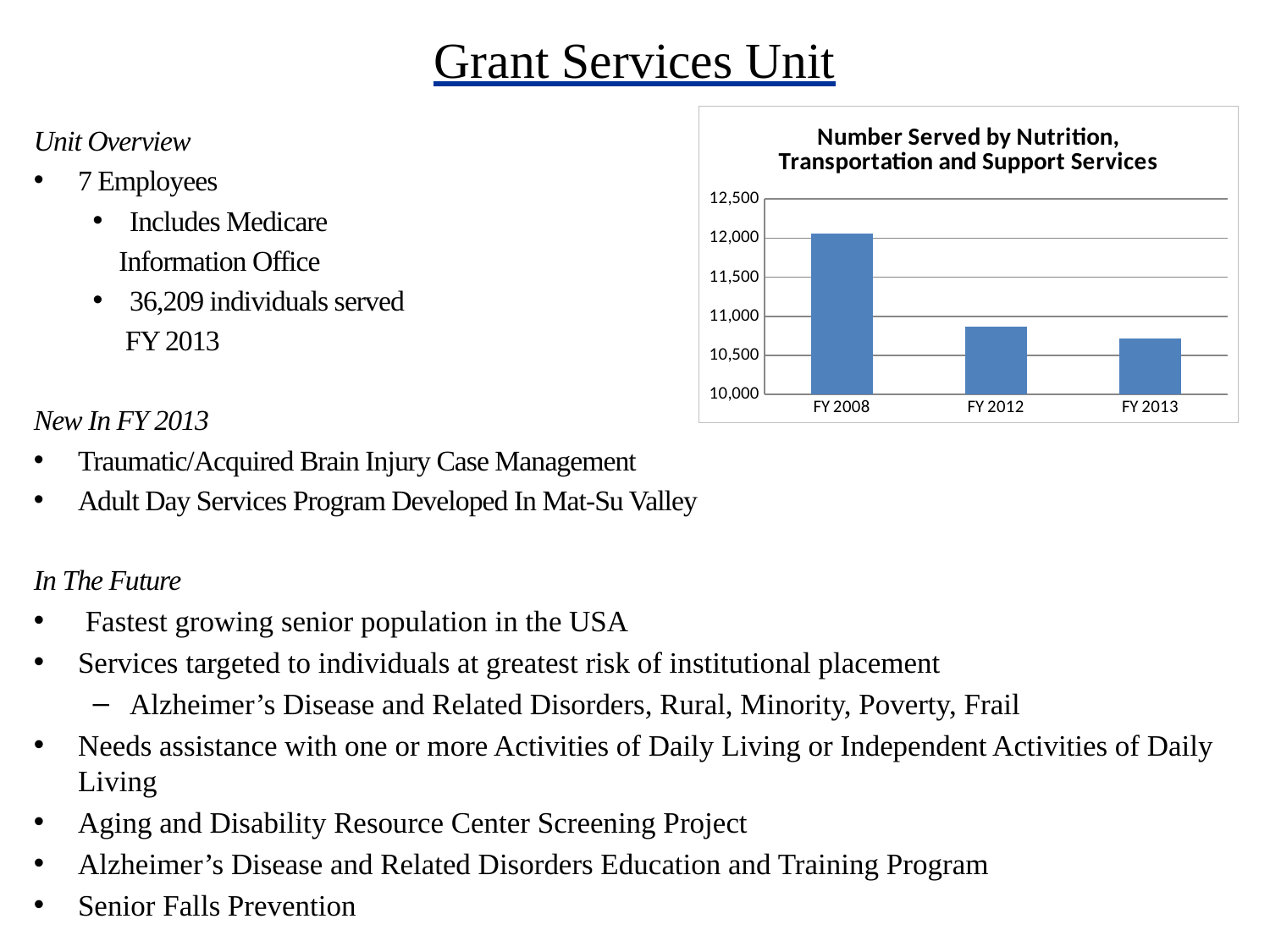
Is the value for FY 2013 greater or less than 10,500? greater What kind of chart is shown on the slide? bar chart Do the values in the chart rise or fall from FY 2008 to FY 2013? fall Which fiscal year has the lowest number served in the chart? FY 2013 Is the value for FY 2013 greater or less than 11,000? less What is the title of the chart? Number Served by Nutrition, Transportation and Support Services Which fiscal year has the highest number served in the chart? FY 2008 What is the lowest value shown on the chart's vertical axis? 10,000 Is the value for FY 2012 greater or less than 11,000? less Which is larger, the value for FY 2008 or the value for FY 2013? FY 2008 How many fiscal years are shown on the x axis of the chart? 3